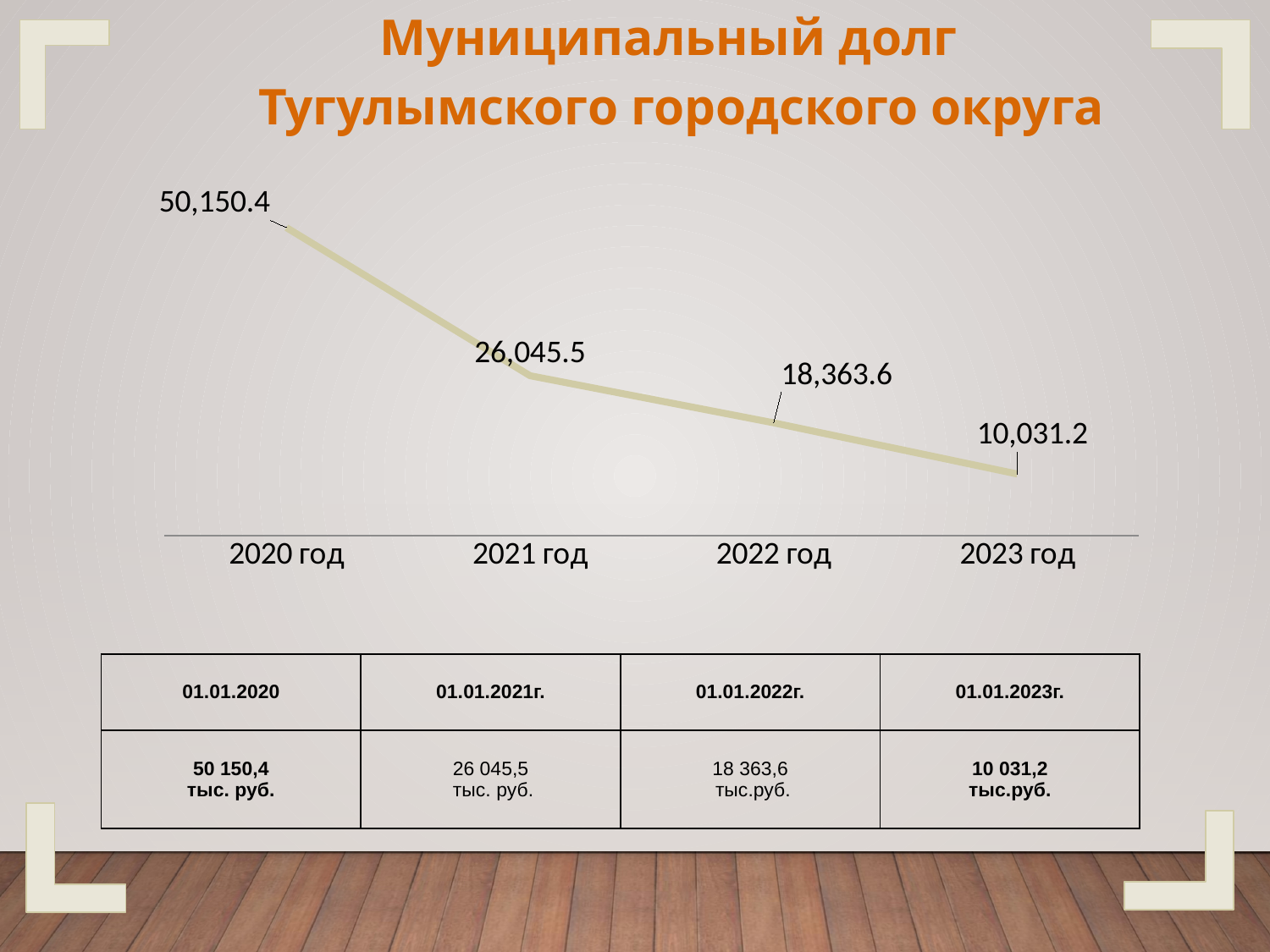
What kind of chart is shown on the slide? line chart What is the value plotted for 2022 год? 18,363.6 What is the difference between the values for 2022 год and 2023 год? 8,332.4 Which year has the highest value on the chart? 2020 год How many data points are plotted on the chart? 4 Which is larger, the value for 2021 год or the value for 2022 год? 2021 год Do the values rise or fall from 2020 год to 2023 год? fall What is the value plotted for 2020 год? 50,150.4 What is the difference between the values for 2020 год and 2021 год? 24,104.9 Which year has the lowest value on the chart? 2023 год What is the value plotted for 2021 год? 26,045.5 What is the value plotted for 2023 год? 10,031.2